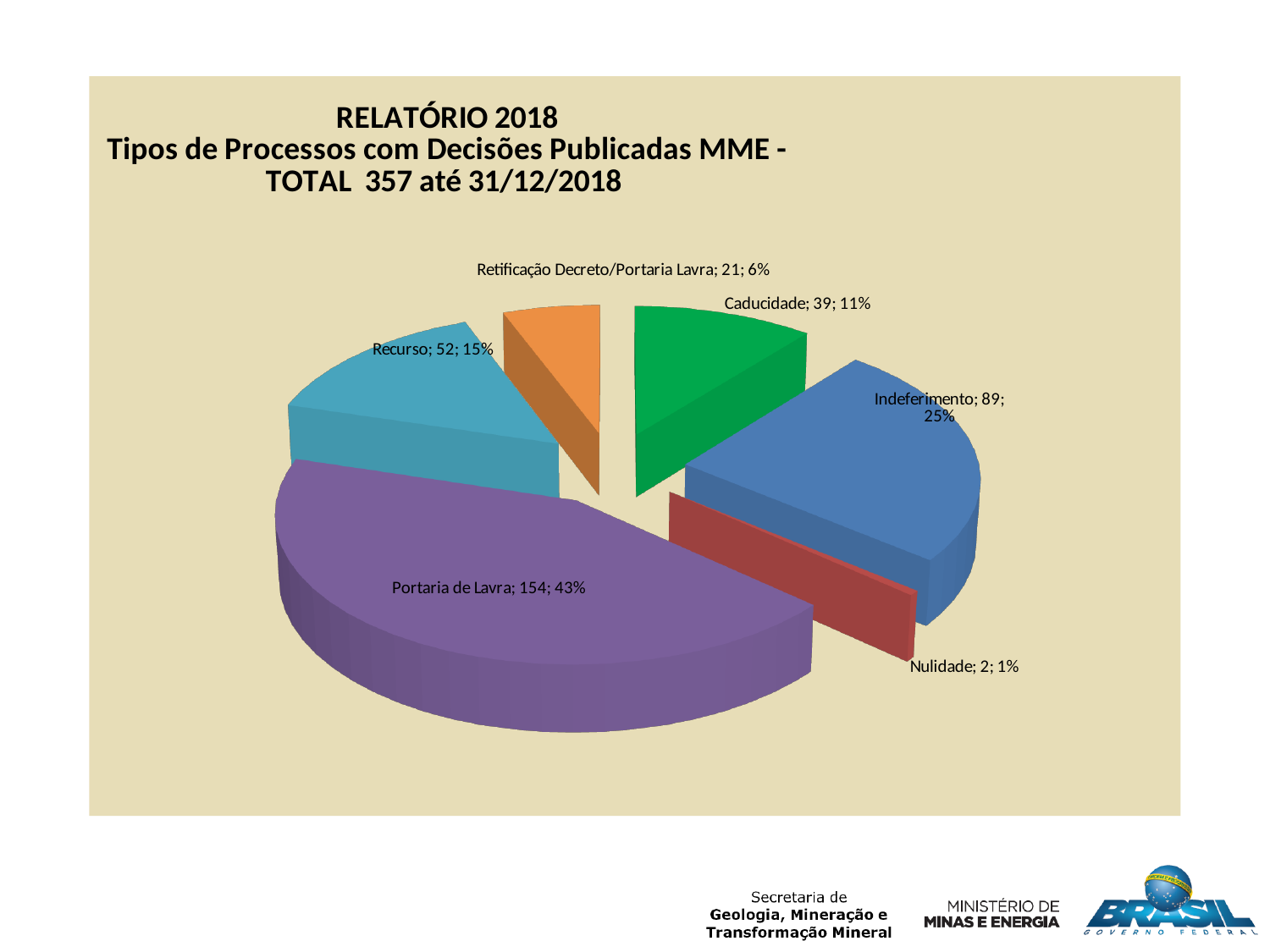
What is the difference between the values for Indeferimento and Caducidade? 50 Which category has the largest slice? Portaria de Lavra What share of the pie does Retificação Decreto/Portaria Lavra represent? 6% What total is stated in the chart title? 357 What is the value for Indeferimento? 89 What kind of chart is shown on the slide? Pie chart What is the value for Recurso? 52 How many slices does the pie chart have? 6 Which is larger, the value for Recurso or the value for Caducidade? Recurso Which category has the smallest slice? Nulidade What is the value for Portaria de Lavra? 154 What share of the pie does Caducidade represent? 11%